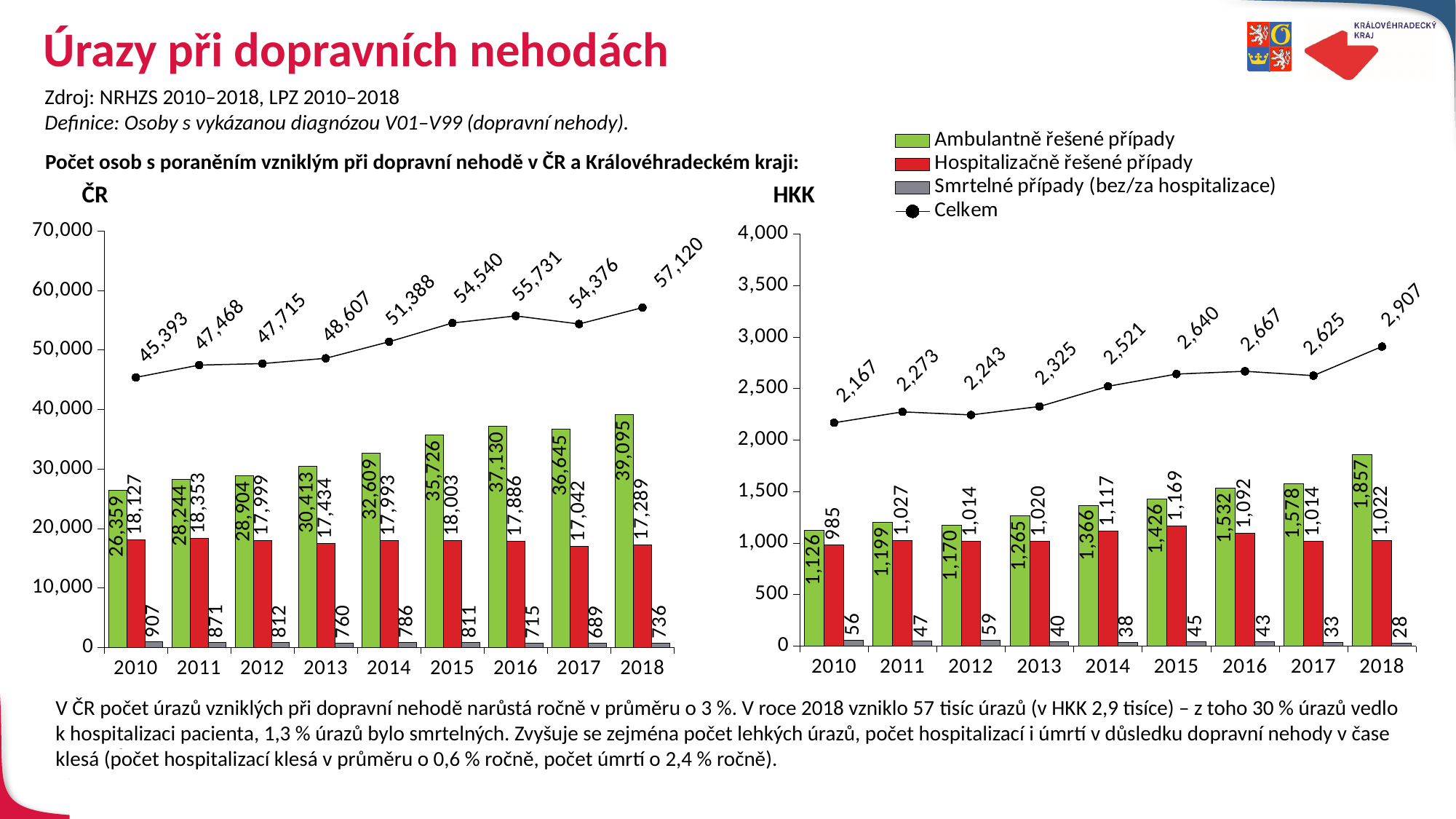
In the ČR chart, what is the value of Celkem for 2018? 57,120 What colour represents Hospitalizačně řešené případy in the legend? Red In the HKK chart, what is the value of Ambulantně řešené případy for 2014? 1,366 In the ČR chart, which year has the highest value of Ambulantně řešené případy? 2018 In the ČR chart, does the Celkem line generally rise or fall from 2010 to 2018? rise In the ČR chart, what is the value of Smrtelné případy for 2017? 689 How many years are shown on the x axis of the HKK chart? 9 In the HKK chart, which year has the lowest value of Smrtelné případy? 2018 In the HKK chart, what is the difference between Celkem in 2018 and Celkem in 2010? 740 How many series does the legend list? 4 In the HKK chart, is the value of Hospitalizačně řešené případy for 2015 greater or less than 1,000? greater In the ČR chart, which is larger: Hospitalizačně řešené případy in 2011 or in 2017? 2011